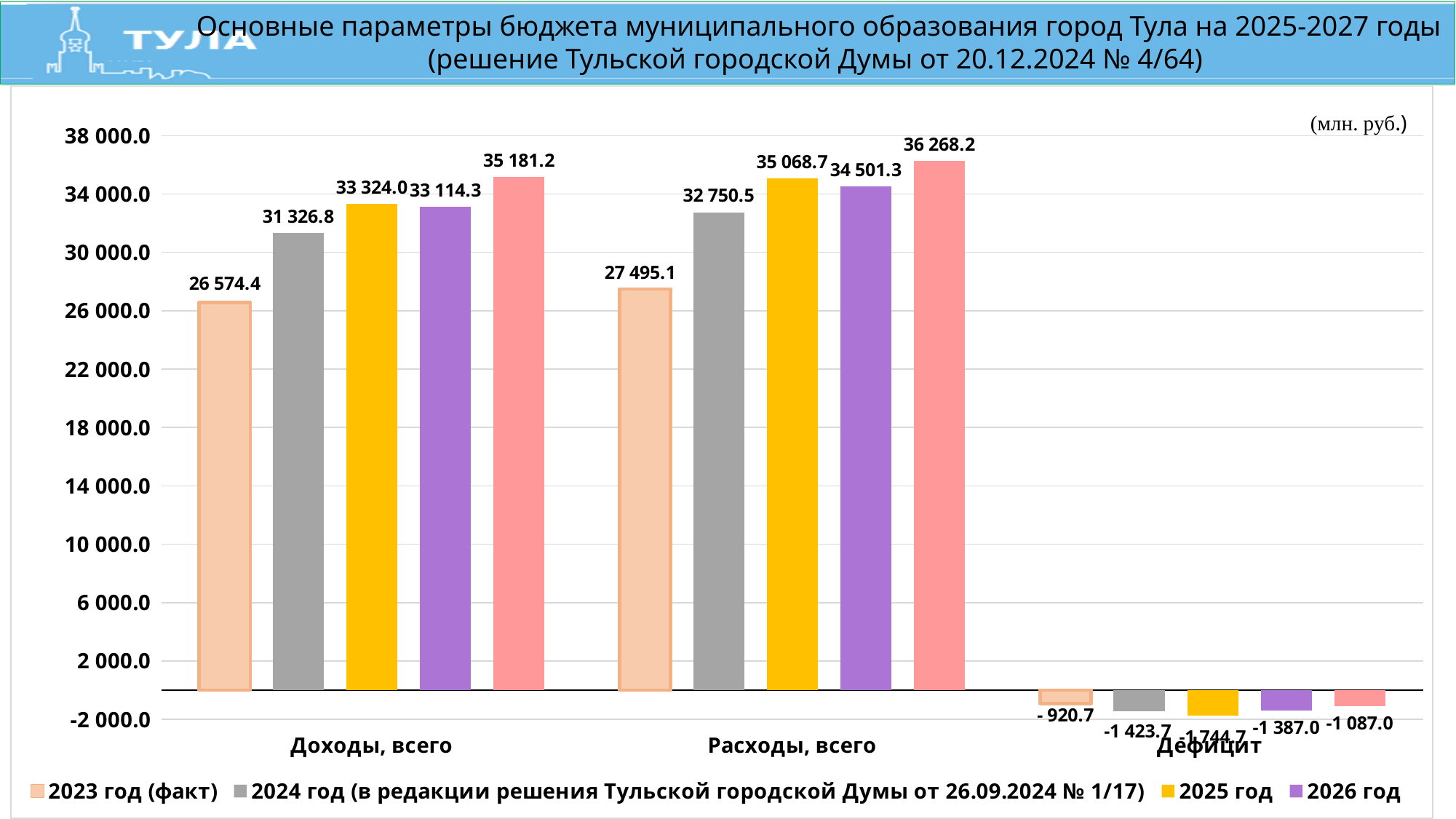
What is the value for 2023 год (факт) in the Доходы, всего category? 26 574.4 What is the value for 2026 год in the Дефицит category? -1 387.0 How many categories are shown on the x axis? 3 What is the value for 2024 год in the Расходы, всего category? 32 750.5 What is the value for 2025 год in the Расходы, всего category? 35 068.7 Is the 2023 год (факт) value for Расходы, всего greater or less than 30 000.0? less Which series has the lowest value in the Дефицит category? 2025 год Which is larger for Доходы, всего: the 2026 год value or the 2024 год value? 2026 год What is the difference between the 2025 год values for Расходы, всего and Доходы, всего? 1 744.7 What is the difference between the 2024 год and 2023 год (факт) values for Доходы, всего? 4 752.4 What kind of chart is shown on the slide? bar chart Which category has the highest value for 2025 год? Расходы, всего